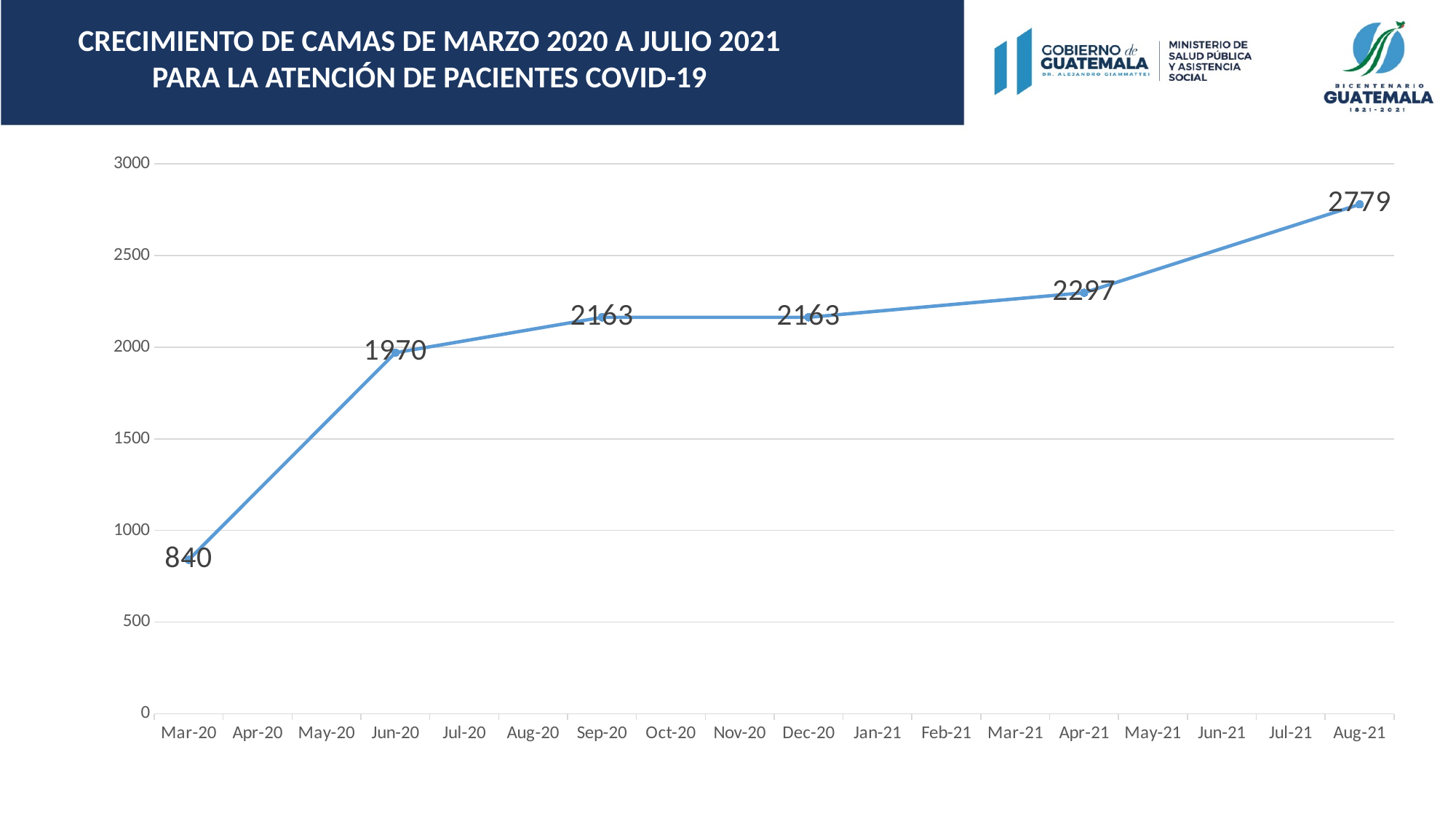
What kind of chart is shown on the slide? line chart Do the plotted values rise or fall from Mar-20 to Aug-21? rise Which month has the lowest plotted value? Mar-20 What is the difference between the values for Aug-21 and Apr-21? 482 What is the value plotted for Mar-20? 840 Is the value for Mar-20 greater or less than 1000? less What is the value plotted for Aug-21? 2779 Which month has the highest plotted value? Aug-21 What is the value plotted for Apr-21? 2297 Which is larger, the value for Sep-20 or the value for Apr-21? Apr-21 What is the difference between the values for Jun-20 and Mar-20? 1130 What is the value plotted for Jun-20? 1970